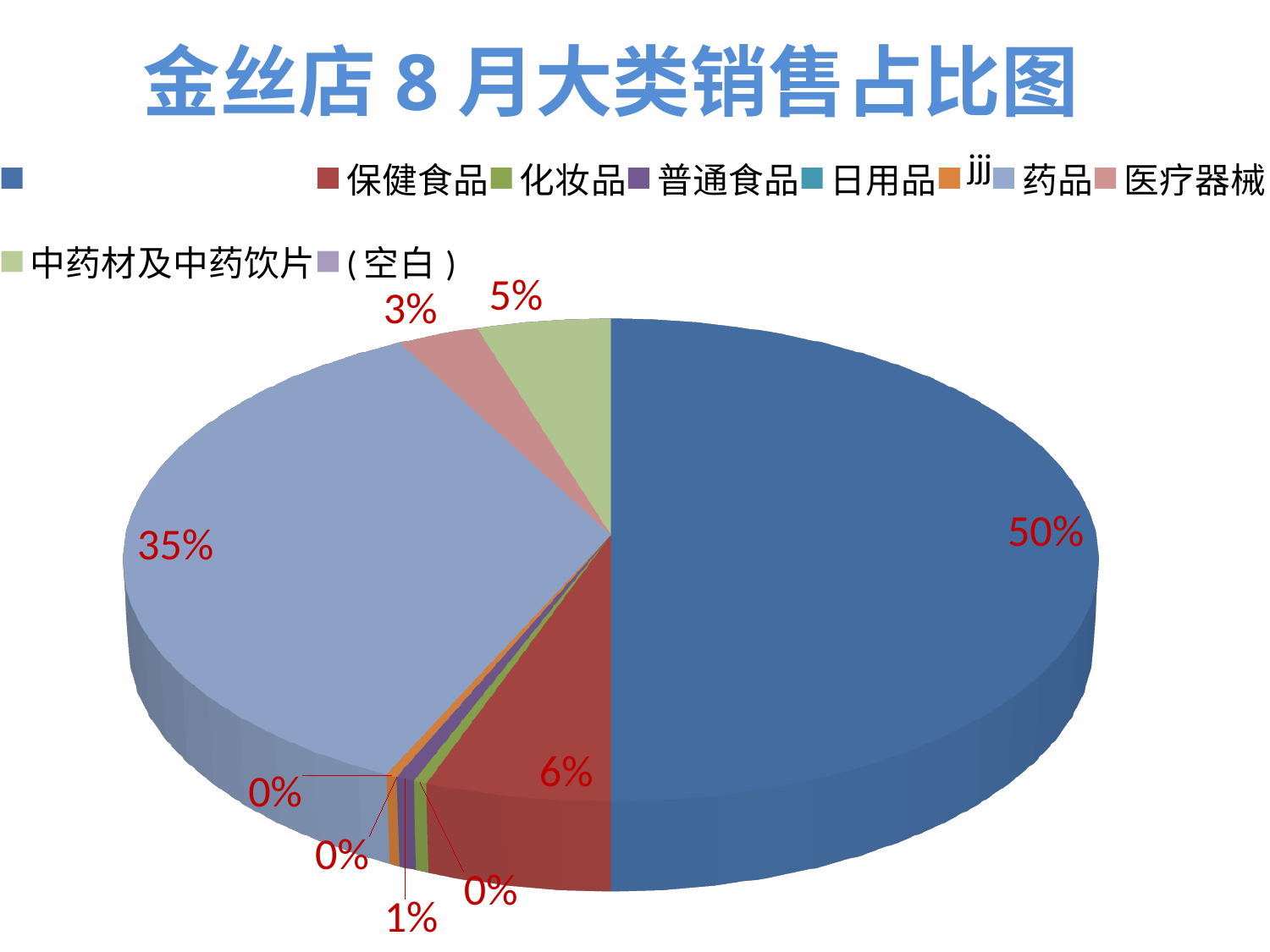
By how many percentage points does the share of 中药材及中药饮片 exceed that of 医疗器械? 2 percentage points What is the title of the chart? 金丝店8月大类销售占比图 What percentage share does 中药材及中药饮片 have in the pie chart? 5% What percentage share does 医疗器械 have in the pie chart? 3% Which has the larger share, 药品 or 保健食品? 药品 What percentage share does 药品 have in the pie chart? 35% What is the largest percentage value labelled on the pie chart? 50% Which has the larger share, 中药材及中药饮片 or 医疗器械? 中药材及中药饮片 What kind of chart is shown on the slide? Pie chart What colour is the 药品 slice in the pie chart? Light blue What percentage share does 保健食品 have in the pie chart? 6% By how many percentage points does the share of 药品 exceed that of 保健食品? 29 percentage points